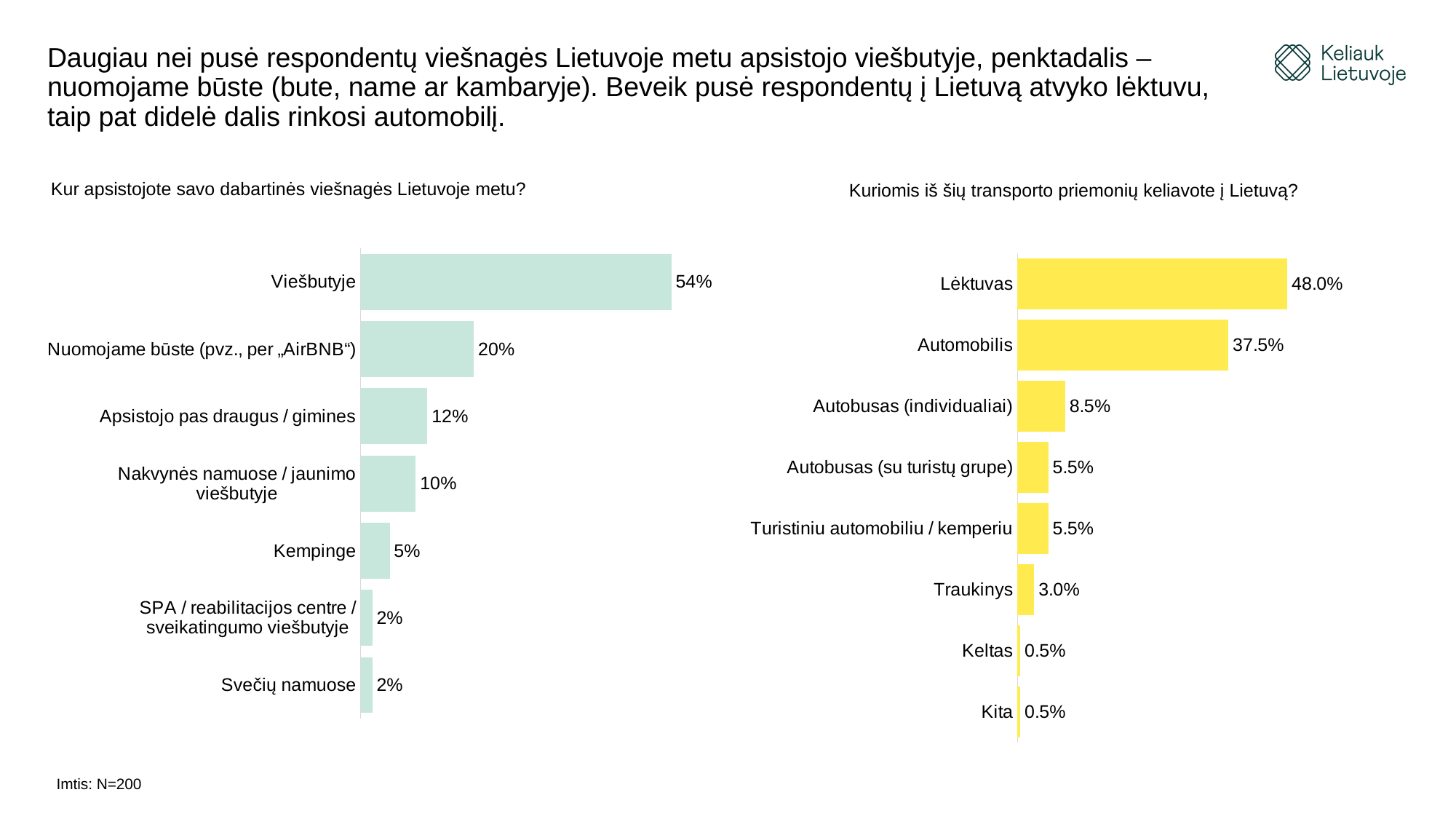
In the right chart (Kuriomis iš šių transporto priemonių keliavote į Lietuvą?), what is the difference between Lėktuvas and Automobilis? 10.5% In the right chart (Kuriomis iš šių transporto priemonių keliavote į Lietuvą?), what is the value for Traukinys? 3.0% In the left chart (Kur apsistojote savo dabartinės viešnagės Lietuvoje metu?), which category has the highest value? Viešbutyje In the right chart (Kuriomis iš šių transporto priemonių keliavote į Lietuvą?), how many categories are shown? 8 In the left chart (Kur apsistojote savo dabartinės viešnagės Lietuvoje metu?), what is the value for Kempinge? 5% In the right chart (Kuriomis iš šių transporto priemonių keliavote į Lietuvą?), which category has the highest value? Lėktuvas In the left chart (Kur apsistojote savo dabartinės viešnagės Lietuvoje metu?), what is the difference between Viešbutyje and Nuomojame būste (pvz., per „AirBNB“)? 34% In the left chart (Kur apsistojote savo dabartinės viešnagės Lietuvoje metu?), which is larger: Apsistojo pas draugus / gimines or Nakvynės namuose / jaunimo viešbutyje? Apsistojo pas draugus / gimines In the left chart (Kur apsistojote savo dabartinės viešnagės Lietuvoje metu?), what is the value for Viešbutyje? 54% In the right chart (Kuriomis iš šių transporto priemonių keliavote į Lietuvą?), what is the value for Automobilis? 37.5% What type of chart is the right chart (Kuriomis iš šių transporto priemonių keliavote į Lietuvą?)? Bar chart In the left chart (Kur apsistojote savo dabartinės viešnagės Lietuvoje metu?), how many categories are shown? 7